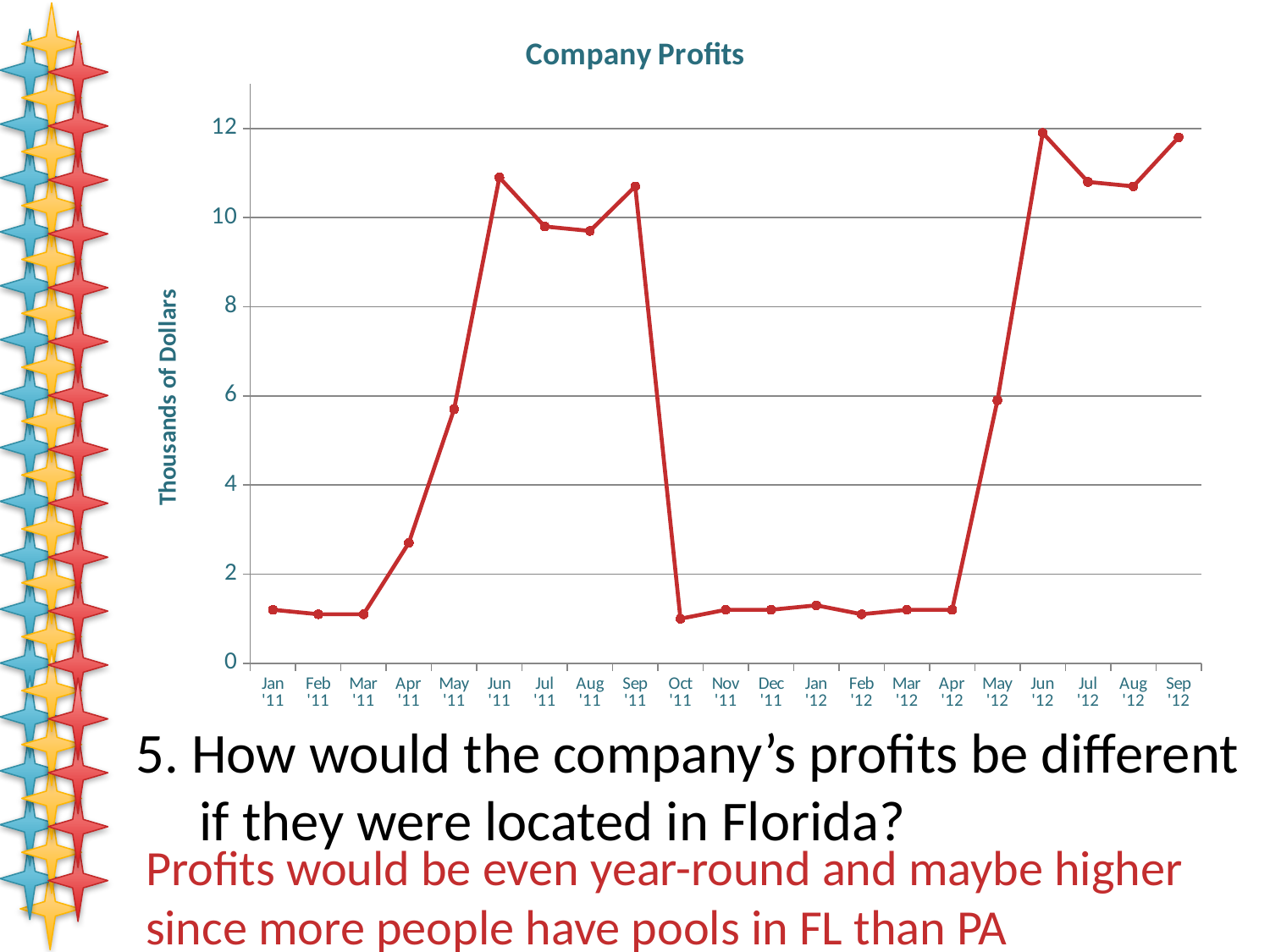
Is the value for Oct '11 greater or less than 2? less What is the title of the chart? Company Profits Which is higher, the value for Jun '11 or the value for Jul '11? Jun '11 Is the value for Aug '12 greater or less than 10? greater How many months are plotted along the x axis of the chart? 21 Which is higher, the value for Sep '11 or the value for Oct '11? Sep '11 What is the label on the vertical axis of the chart? Thousands of Dollars Is the value for Jan '12 greater or less than 2? less What kind of chart is shown on the slide? line chart Do the values rise or fall from Mar '11 to Jun '11? rise